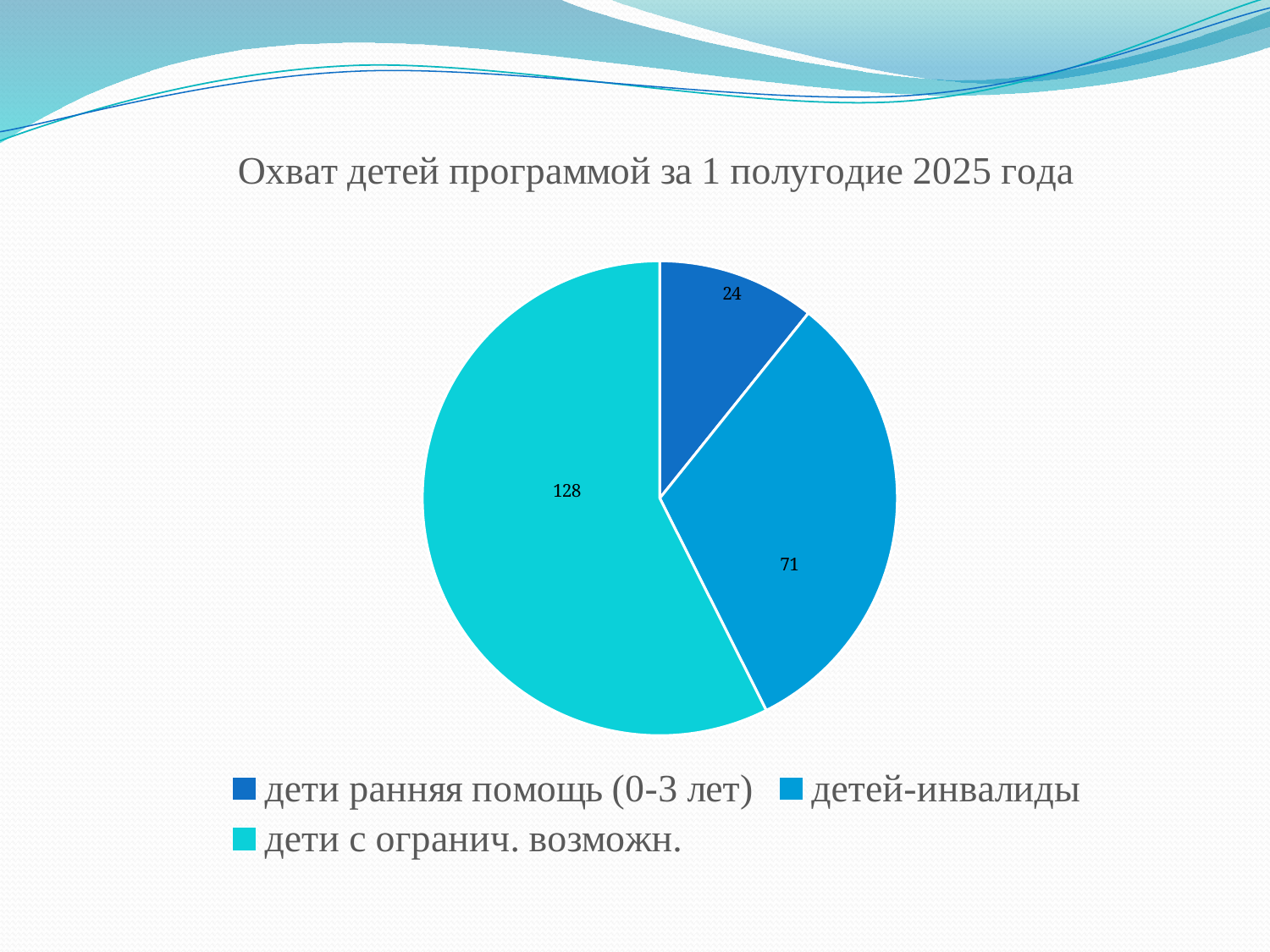
Which category has the largest slice? дети с огранич. возможн. What is the value for 'детей-инвалиды'? 71 What is the total of all three slices in the pie chart? 223 What is the value for 'дети с огранич. возможн.'? 128 What kind of chart is shown on the slide? Pie chart What is the title of the chart? Охват детей программой за 1 полугодие 2025 года How many slices does the pie chart have? 3 How many entries does the legend list? 3 Which is larger: the value for 'детей-инвалиды' or for 'дети ранняя помощь (0-3 лет)'? детей-инвалиды What is the value for 'дети ранняя помощь (0-3 лет)'? 24 What is the difference between the values for 'дети с огранич. возможн.' and 'детей-инвалиды'? 57 Which category has the smallest slice? дети ранняя помощь (0-3 лет)